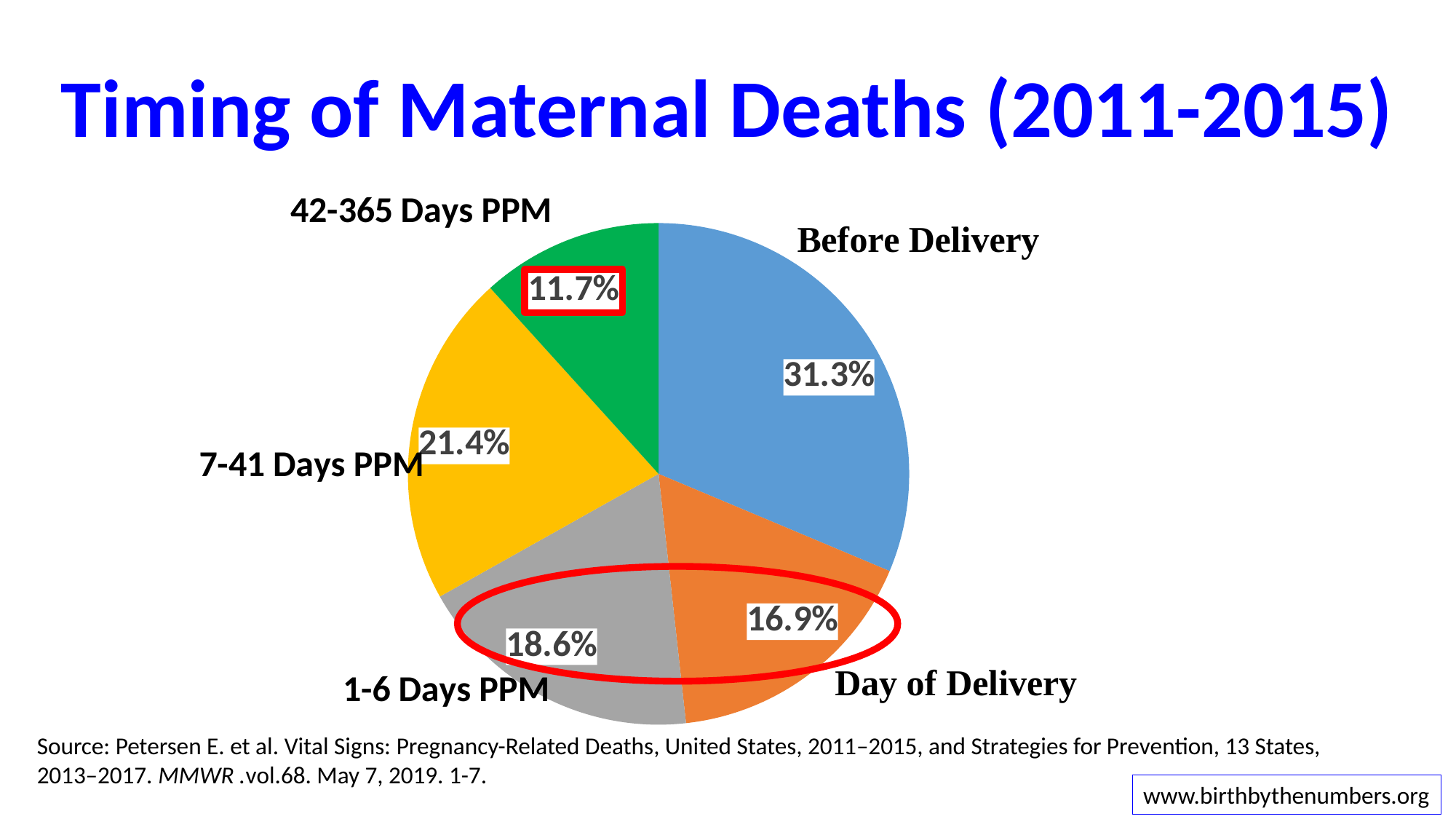
What type of chart is shown on the slide? Pie chart Which is larger, the share for 1-6 Days PPM or the share for Day of Delivery? 1-6 Days PPM How many timing categories are shown in the pie chart? 5 What share of maternal deaths occurred 7-41 days PPM? 21.4% What share of maternal deaths occurred before delivery? 31.3% What share of maternal deaths occurred on the day of delivery? 16.9% What share of maternal deaths occurred 1-6 days PPM? 18.6% Which timing category has the largest share of maternal deaths? Before Delivery Which timing category has the smallest share of maternal deaths? 42-365 Days PPM What share of maternal deaths occurred 42-365 days PPM? 11.7% What is the difference in percentage points between the Before Delivery share and the 42-365 Days PPM share? 19.6 What is the title of the chart on the slide? Timing of Maternal Deaths (2011-2015)